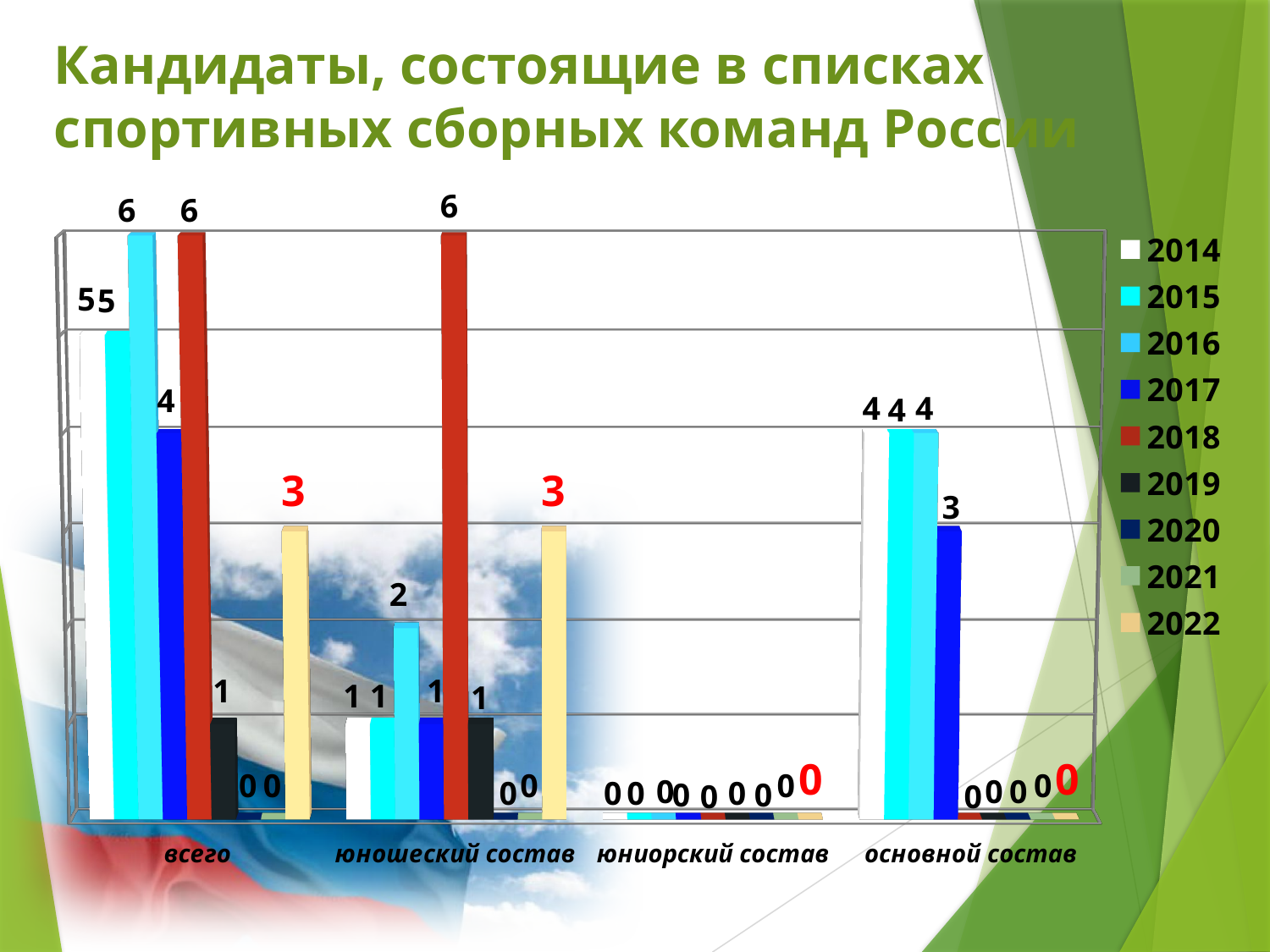
In the 'всего' category, which is larger: the value for 2017 or the value for 2022? 2017 How many categories are shown on the x axis? 4 What is the last year listed in the legend? 2022 What is the difference between the 2016 and 2019 values in the 'всего' category? 5 What kind of chart is shown on the slide? bar chart What is the value for 2017 in the 'основной состав' category? 3 How many series does the legend list? 9 What is the value for 2022 in the 'юношеский состав' category? 3 What is the value for 2019 in the 'всего' category? 1 What is the value for 2018 in the 'всего' category? 6 Which year has the highest value in the 'юношеский состав' category? 2018 What is the value for 2016 in the 'юношеский состав' category? 2